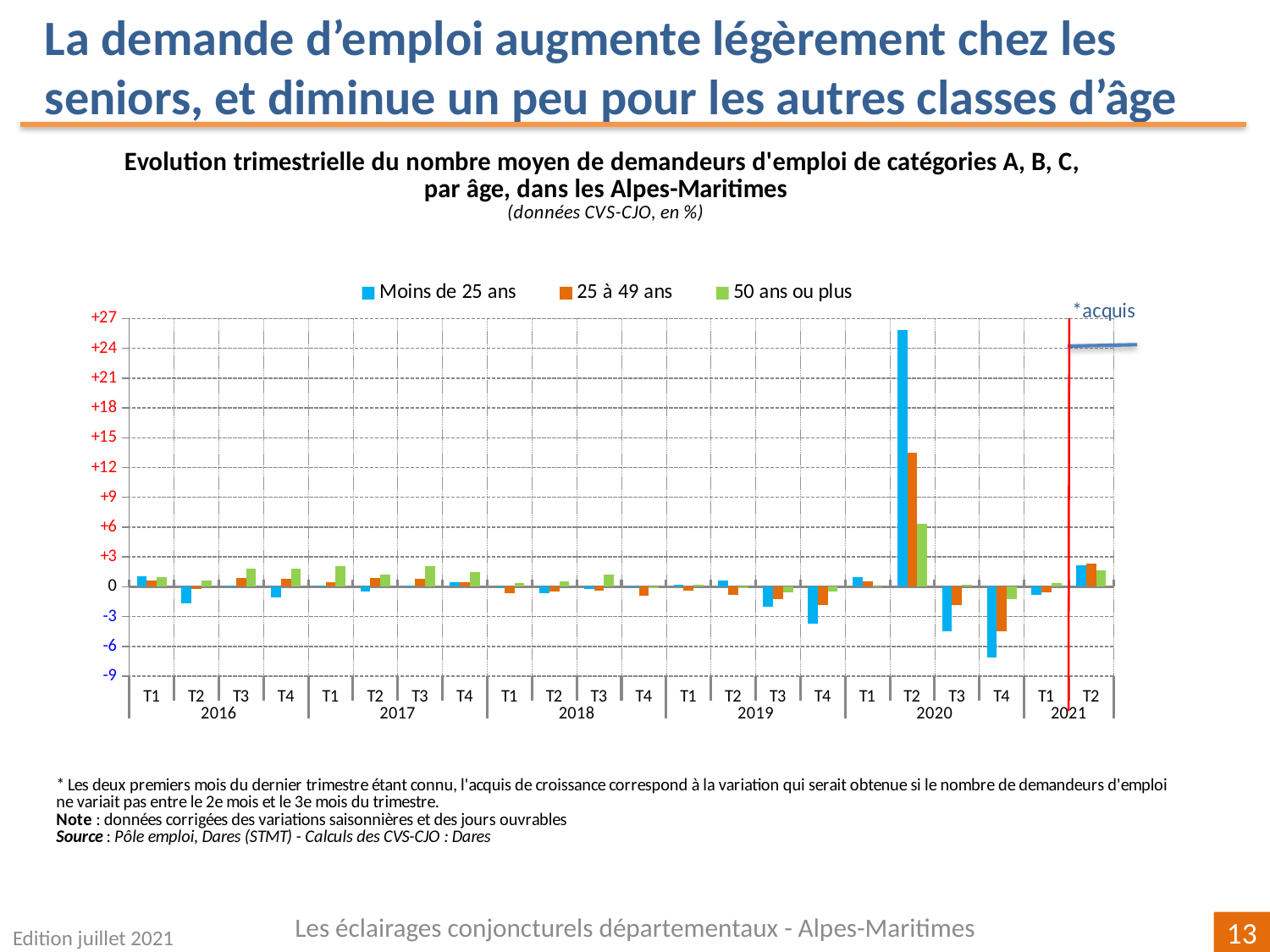
What kind of chart is shown on the slide? bar chart Is the value for '50 ans ou plus' in T2 2020 greater or less than +3? greater Which colour represents the '50 ans ou plus' series? green In which quarter does the 'Moins de 25 ans' series reach its lowest value? T4 2020 Is the value for 'Moins de 25 ans' in T2 2020 greater or less than +21? greater How many series does the legend list? 3 Is the value for 'Moins de 25 ans' in T4 2020 greater or less than -6? less In T2 2020, which series has the larger value: 'Moins de 25 ans' or '25 à 49 ans'? Moins de 25 ans What label is written next to the red vertical line at the right of the chart? *acquis In which quarter does the 'Moins de 25 ans' series reach its highest value? T2 2020 How many quarters are plotted along the x axis? 22